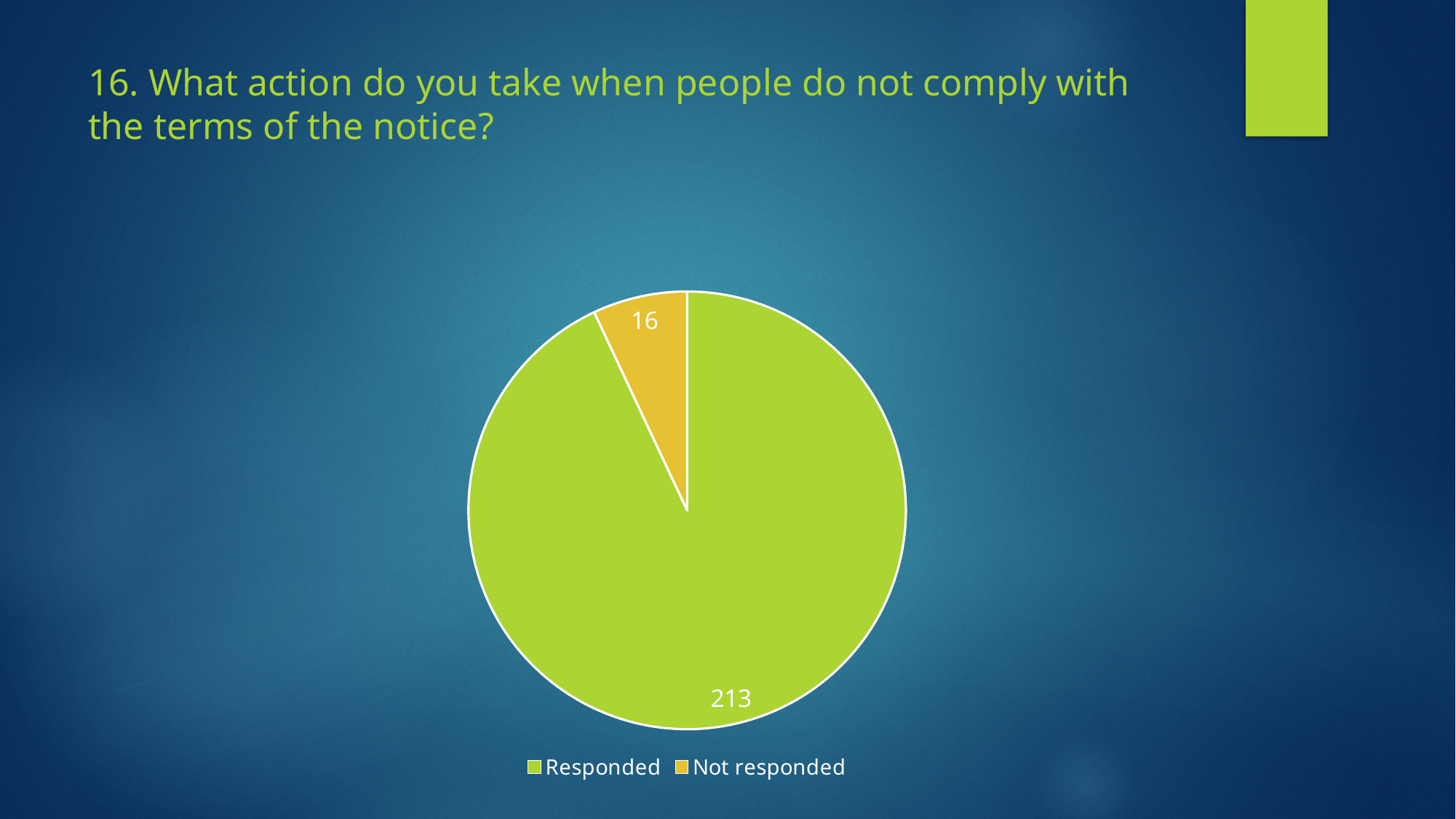
Which is larger, Responded or Not responded? Responded What is the difference between the Responded and Not responded values? 197 Which category has the smallest slice? Not responded Which category has the largest slice? Responded What is the value for Not responded? 16 What is the value for Responded? 213 How many slices does the pie chart have? 2 What colour is the Not responded slice? yellow/orange How many entries does the legend list? 2 What is the title of the slide containing the chart? 16. What action do you take when people do not comply with the terms of the notice? What type of chart is shown on the slide? pie chart What is the total of the two slices? 229